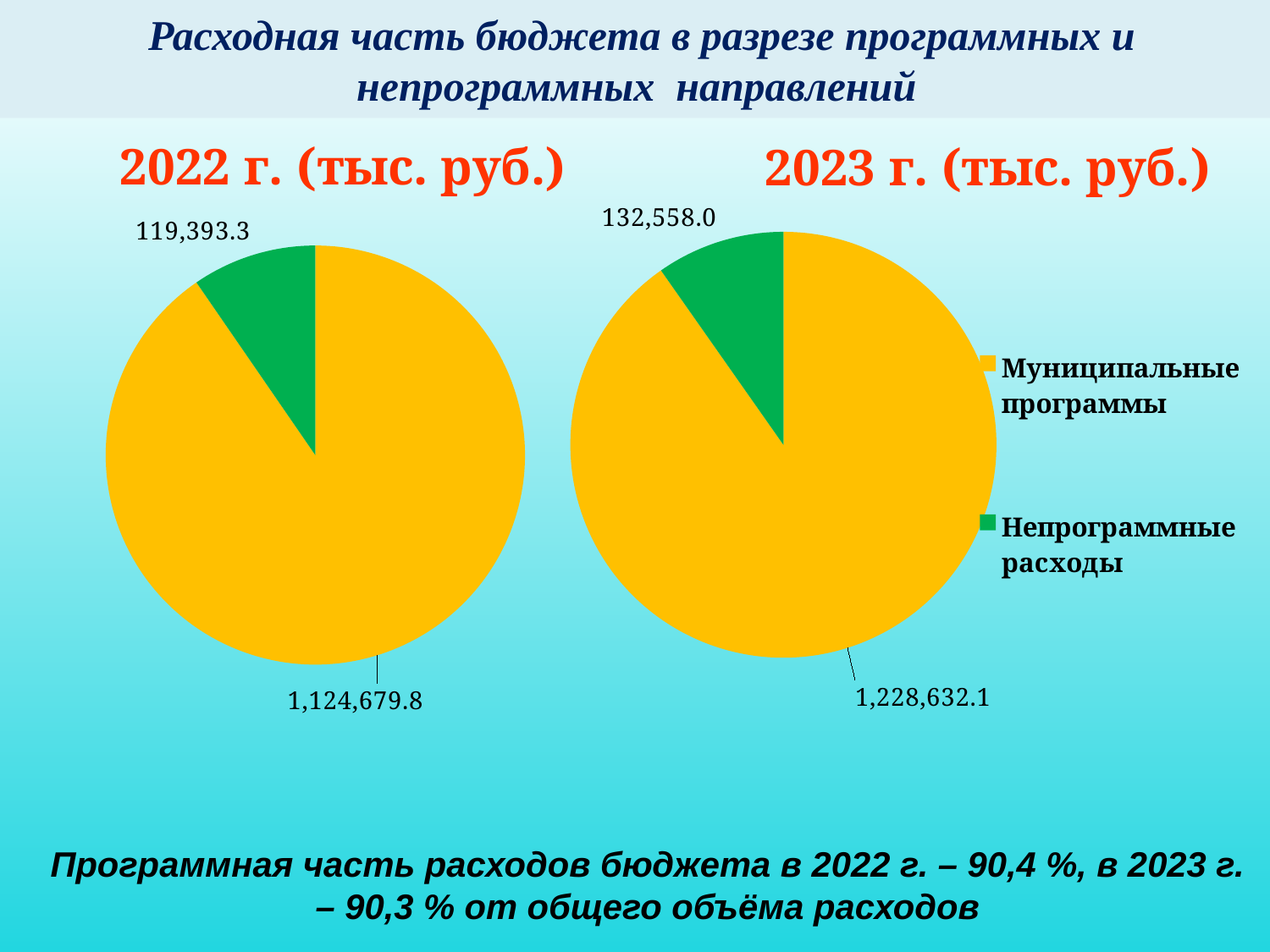
In the 2023 г. (тыс. руб.) chart, what is the value for Непрограммные расходы? 132,558.0 In the 2023 г. (тыс. руб.) chart, what is the value for Муниципальные программы? 1,228,632.1 In the 2022 г. (тыс. руб.) chart, what is the value for Муниципальные программы? 1,124,679.8 How much larger is the value for Муниципальные программы in the 2023 г. chart than in the 2022 г. chart? 103,952.3 What type of chart is used on this slide for the 2022 г. (тыс. руб.) data? Pie chart In the 2022 г. (тыс. руб.) chart, which category has the smallest slice? Непрограммные расходы How many series does the legend list for the pie charts? 2 In the 2022 г. (тыс. руб.) chart, what is the value for Непрограммные расходы? 119,393.3 What is the difference between Непрограммные расходы in the 2023 г. chart and in the 2022 г. chart? 13,164.7 In the 2023 г. (тыс. руб.) chart, which category has the largest slice? Муниципальные программы Is the value for Непрограммные расходы larger in the 2022 г. chart or in the 2023 г. chart? 2023 г. What colour represents Непрограммные расходы in the pie charts? Green